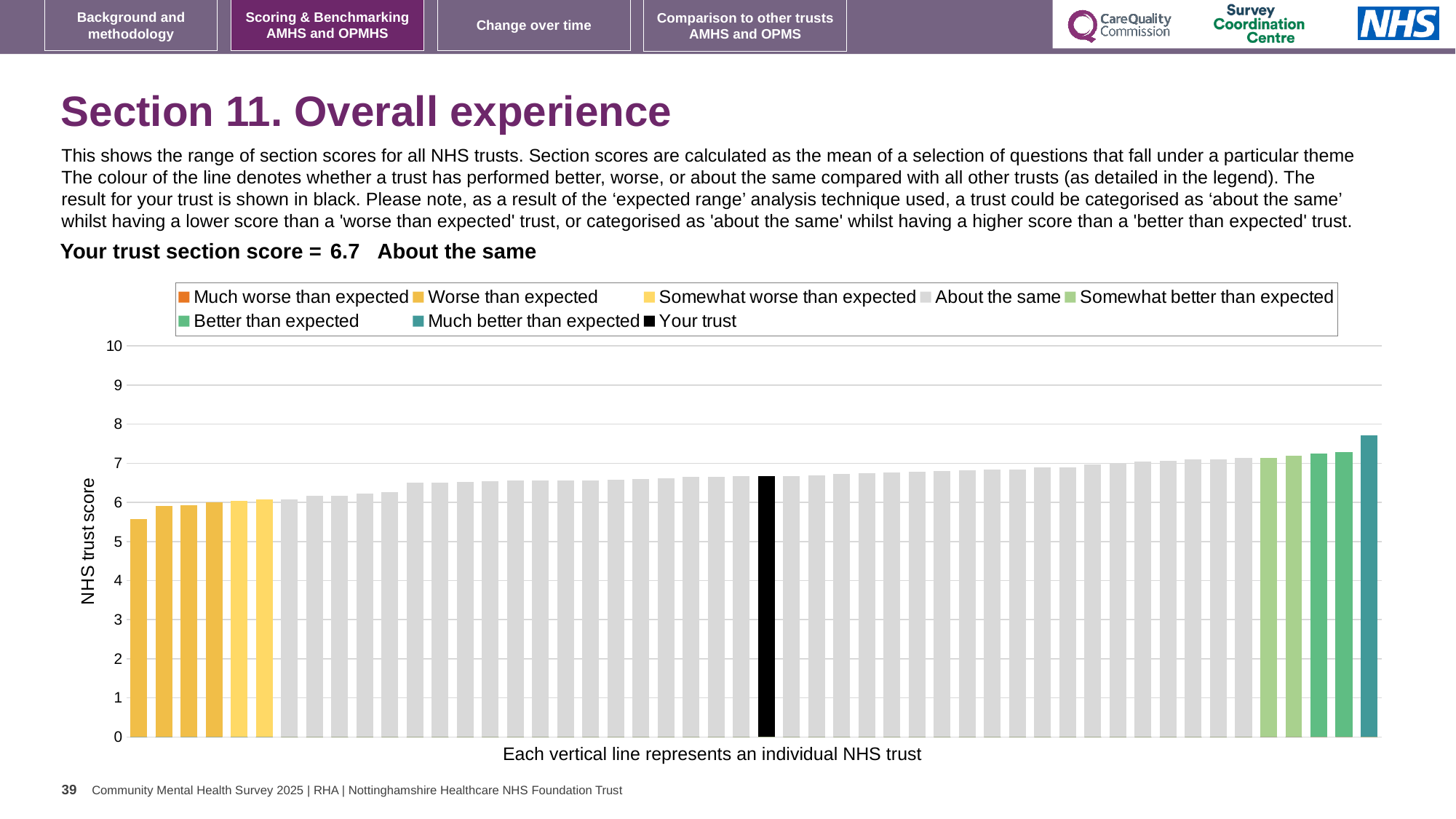
Which category is your trust's section score placed in? About the same How many entries does the chart legend list? 8 What does each vertical line in the chart represent, according to the x-axis label? An individual NHS trust Is the value of the highest bar in the chart greater or less than 7? greater What kind of chart is shown on the slide? Bar chart What is the section score for your trust shown on the slide? 6.7 Which is larger: the black bar for your trust or the tallest bar at the right end of the chart? The tallest bar at the right end Is the value of the lowest bar in the chart greater or less than 6? less What is the label on the vertical axis of the chart? NHS trust score Do the bar values rise or fall from left to right across the chart? Rise Is the black bar for your trust greater or less than 5? greater How many bars are coloured as 'Much better than expected' (teal)? 1